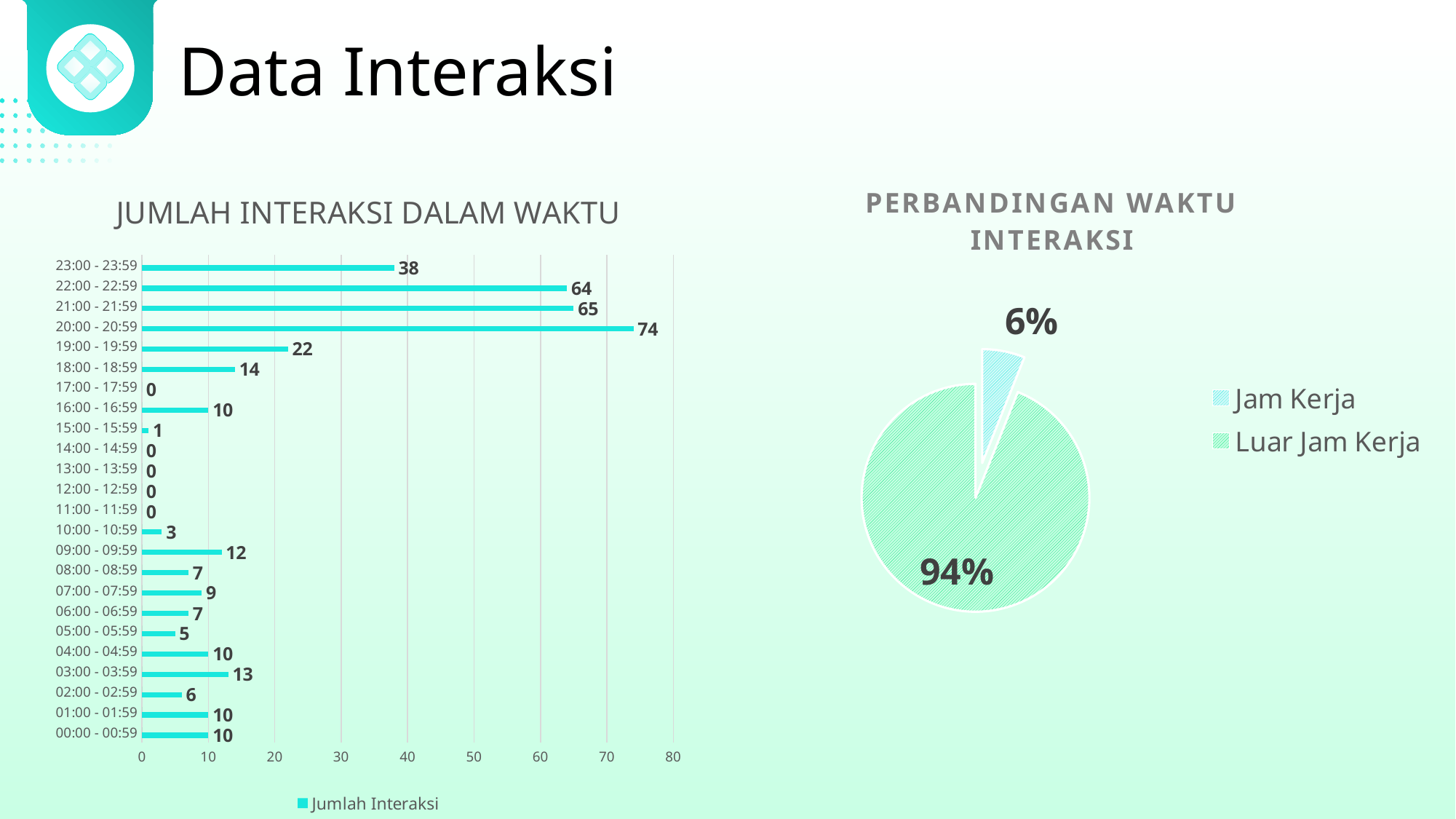
In the 'JUMLAH INTERAKSI DALAM WAKTU' chart, which time slot has the highest number of interactions? 20:00 - 20:59 In the 'JUMLAH INTERAKSI DALAM WAKTU' chart, what is the value for 20:00 - 20:59? 74 In the 'JUMLAH INTERAKSI DALAM WAKTU' chart, how many time slots have a value of 0? 5 In the 'JUMLAH INTERAKSI DALAM WAKTU' chart, what series name does the legend show? Jumlah Interaksi How many entries does the legend of the 'PERBANDINGAN WAKTU INTERAKSI' pie chart list? 2 In the 'JUMLAH INTERAKSI DALAM WAKTU' chart, what is the value for 03:00 - 03:59? 13 In the 'PERBANDINGAN WAKTU INTERAKSI' pie chart, what share does 'Luar Jam Kerja' have? 94% In the 'JUMLAH INTERAKSI DALAM WAKTU' chart, what is the difference between the values for 21:00 - 21:59 and 22:00 - 22:59? 1 What kind of chart is 'JUMLAH INTERAKSI DALAM WAKTU'? Bar chart In the 'JUMLAH INTERAKSI DALAM WAKTU' chart, how many time-slot categories are shown? 24 In the 'PERBANDINGAN WAKTU INTERAKSI' pie chart, what share does 'Jam Kerja' have? 6% In the 'JUMLAH INTERAKSI DALAM WAKTU' chart, which is larger: the value for 19:00 - 19:59 or the value for 18:00 - 18:59? 19:00 - 19:59